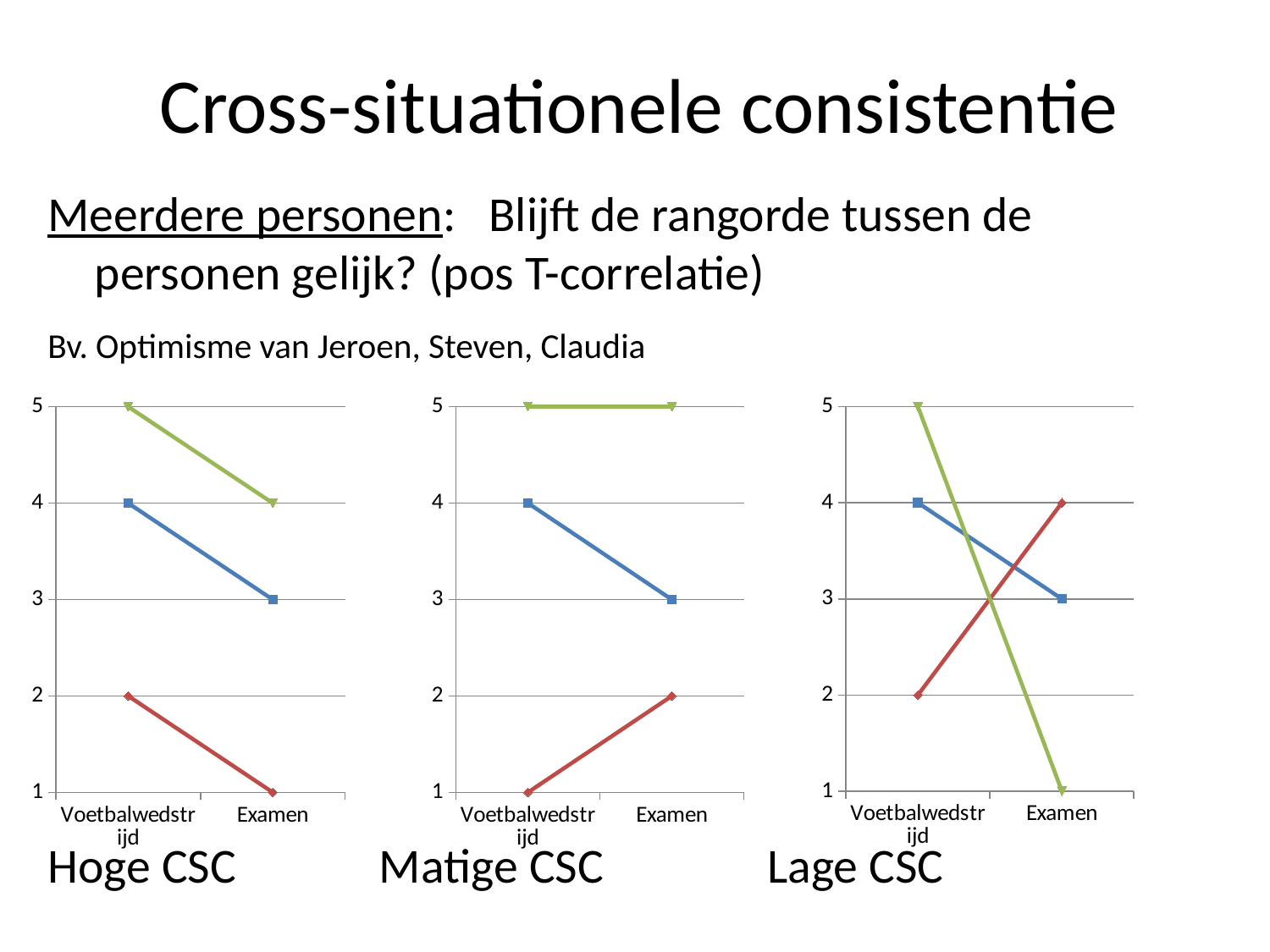
In the Hoge CSC chart, does the blue line rise or fall from Voetbalwedstrijd to Examen? fall In the Matige CSC chart, what is the value of the green line at Examen? 5 How many categories are on the x axis of the Hoge CSC chart? 2 In the Lage CSC chart, what is the value of the green line at Examen? 1 In the Lage CSC chart, what is the difference between the green line's value at Voetbalwedstrijd and at Examen? 4 In the Lage CSC chart, at Voetbalwedstrijd, is the blue line's value larger or smaller than the red line's value? larger What kind of chart is the left chart labelled Hoge CSC? line chart In the Matige CSC chart, what is the difference between the blue line's value at Voetbalwedstrijd and at Examen? 1 In the Lage CSC chart, which line has the highest value at Examen? the red line In the Matige CSC chart, does the red line rise or fall from Voetbalwedstrijd to Examen? rise In the Hoge CSC chart, what is the value of the red line at Voetbalwedstrijd? 2 In the Hoge CSC chart, what is the value of the green line at Examen? 4